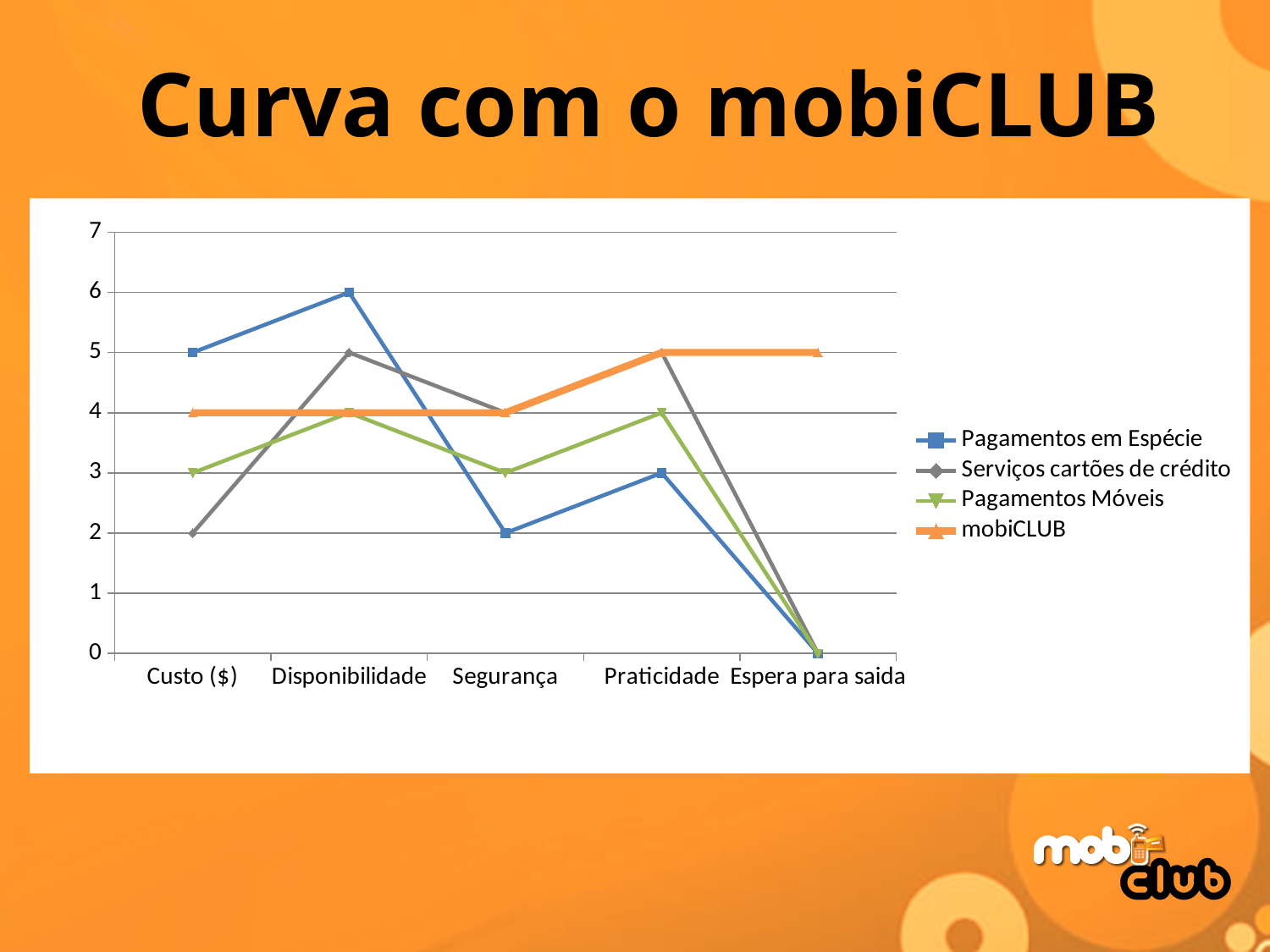
What is the value for mobiCLUB at Espera para saida? 5 What is the value for Pagamentos Móveis at Segurança? 3 Which is larger at Segurança: Pagamentos em Espécie or Serviços cartões de crédito? Serviços cartões de crédito What is the value for Serviços cartões de crédito at Custo ($)? 2 Which series has the lowest value at Custo ($)? Serviços cartões de crédito How many series does the legend list? 4 How many categories are shown on the x axis? 5 What is the difference between Pagamentos em Espécie and mobiCLUB at Disponibilidade? 2 What kind of chart is shown on the slide? Line chart Which series has the highest value at Espera para saida? mobiCLUB What is the value for Pagamentos em Espécie at Disponibilidade? 6 What is the title of the slide? Curva com o mobiCLUB